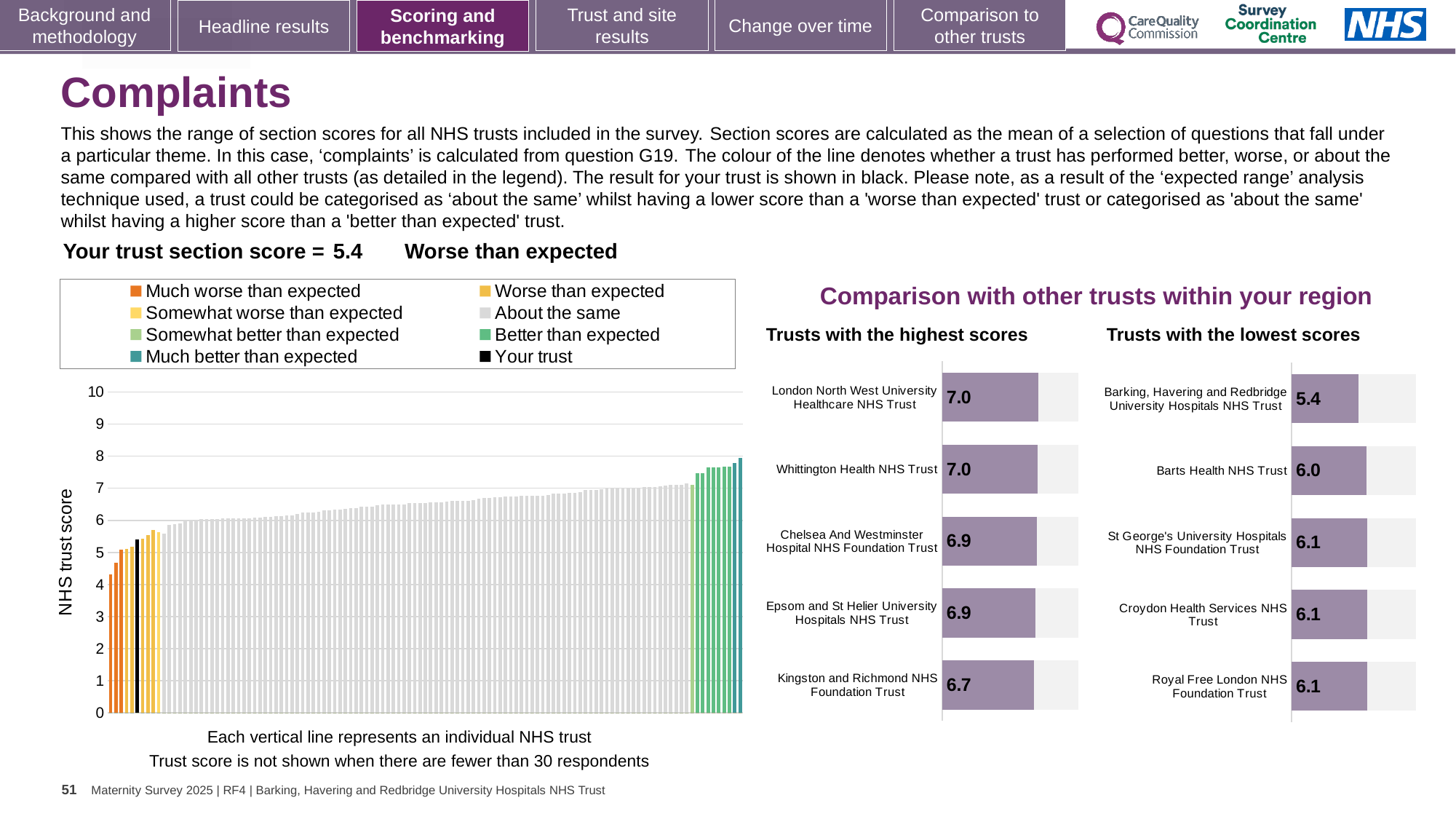
In the 'Trusts with the lowest scores' chart, what is the difference between the scores of Barts Health NHS Trust and Barking, Havering and Redbridge University Hospitals NHS Trust? 0.6 In the 'Trusts with the lowest scores' chart, what is the score for Barking, Havering and Redbridge University Hospitals NHS Trust? 5.4 In the 'Trusts with the highest scores' chart, what is the score for Kingston and Richmond NHS Foundation Trust? 6.7 In the 'Trusts with the highest scores' chart, what is the difference between the scores of London North West University Healthcare NHS Trust and Kingston and Richmond NHS Foundation Trust? 0.3 In the 'Trusts with the lowest scores' chart, what is the score for Barts Health NHS Trust? 6.0 In the 'Trusts with the highest scores' chart, which has the higher score: Chelsea And Westminster Hospital NHS Foundation Trust or Kingston and Richmond NHS Foundation Trust? Chelsea And Westminster Hospital NHS Foundation Trust In the large chart on the left, is the value for the black 'Your trust' bar greater or less than 6? less What kind of chart is the large chart on the left with the 'NHS trust score' axis? Bar chart In the 'Trusts with the highest scores' chart, what is the score for London North West University Healthcare NHS Trust? 7.0 In the 'Trusts with the lowest scores' chart, which trust has the lowest score? Barking, Havering and Redbridge University Hospitals NHS Trust In the 'Trusts with the highest scores' chart, which trust has the lowest score shown? Kingston and Richmond NHS Foundation Trust How many trusts are listed in the 'Trusts with the lowest scores' chart? 5